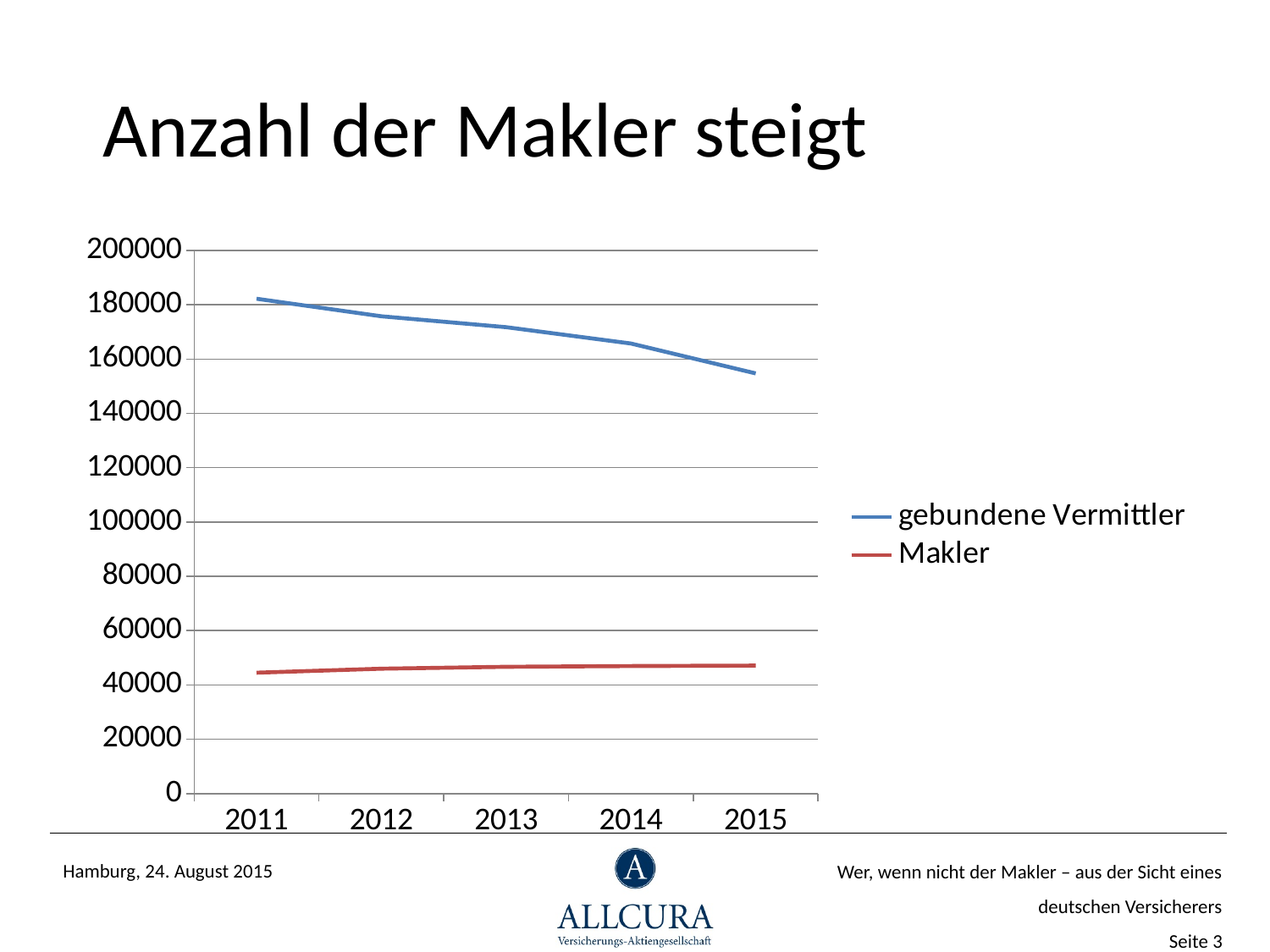
What kind of chart is shown on the slide? line chart Which series has the larger value in 2015, gebundene Vermittler or Makler? gebundene Vermittler How many series does the legend list? 2 Is the value for Makler in 2015 greater or less than 60000? less In which year is the value for gebundene Vermittler highest? 2011 What is the title of the slide? Anzahl der Makler steigt How many years are shown on the x axis? 5 In which year is the value for gebundene Vermittler lowest? 2015 Does the value for Makler rise or fall from 2011 to 2015? rise Is the value for gebundene Vermittler in 2011 greater or less than 180000? greater Is the value for gebundene Vermittler in 2015 greater or less than 160000? less Does the value for gebundene Vermittler rise or fall from 2011 to 2015? fall